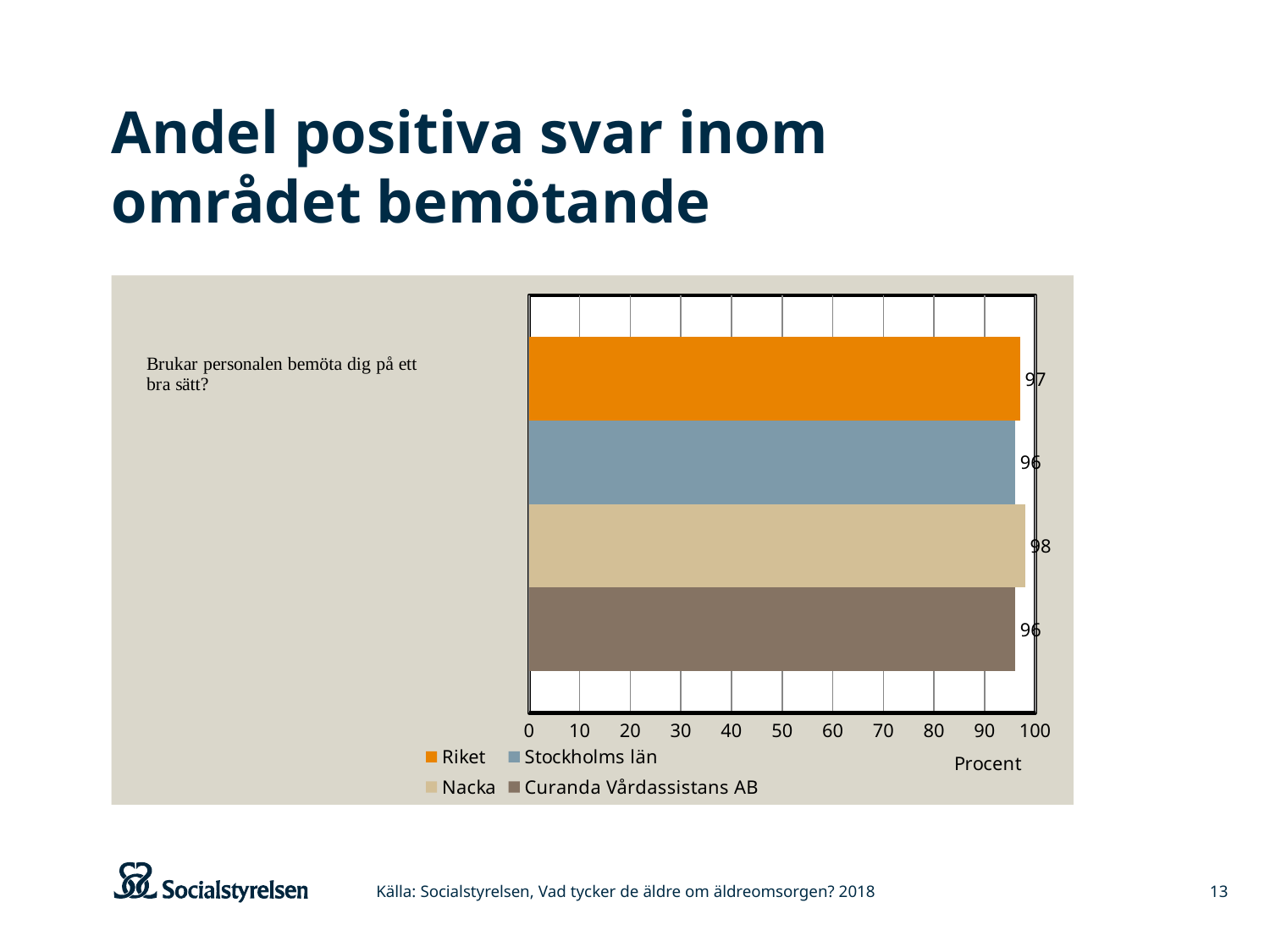
Which is larger, the value for Nacka or the value for Riket? Nacka What is the value for Stockholms län? 96 What kind of chart is shown on the slide? bar chart What is the value for Riket? 97 Which series has the highest value? Nacka What is the label on the horizontal axis of the chart? Procent What is the difference between the values for Riket and Curanda Vårdassistans AB? 1 How many series does the legend list? 4 What is the value for Curanda Vårdassistans AB? 96 What is the value for Nacka? 98 What is the difference between the values for Nacka and Stockholms län? 2 Is the value for Curanda Vårdassistans AB greater or less than 90? greater